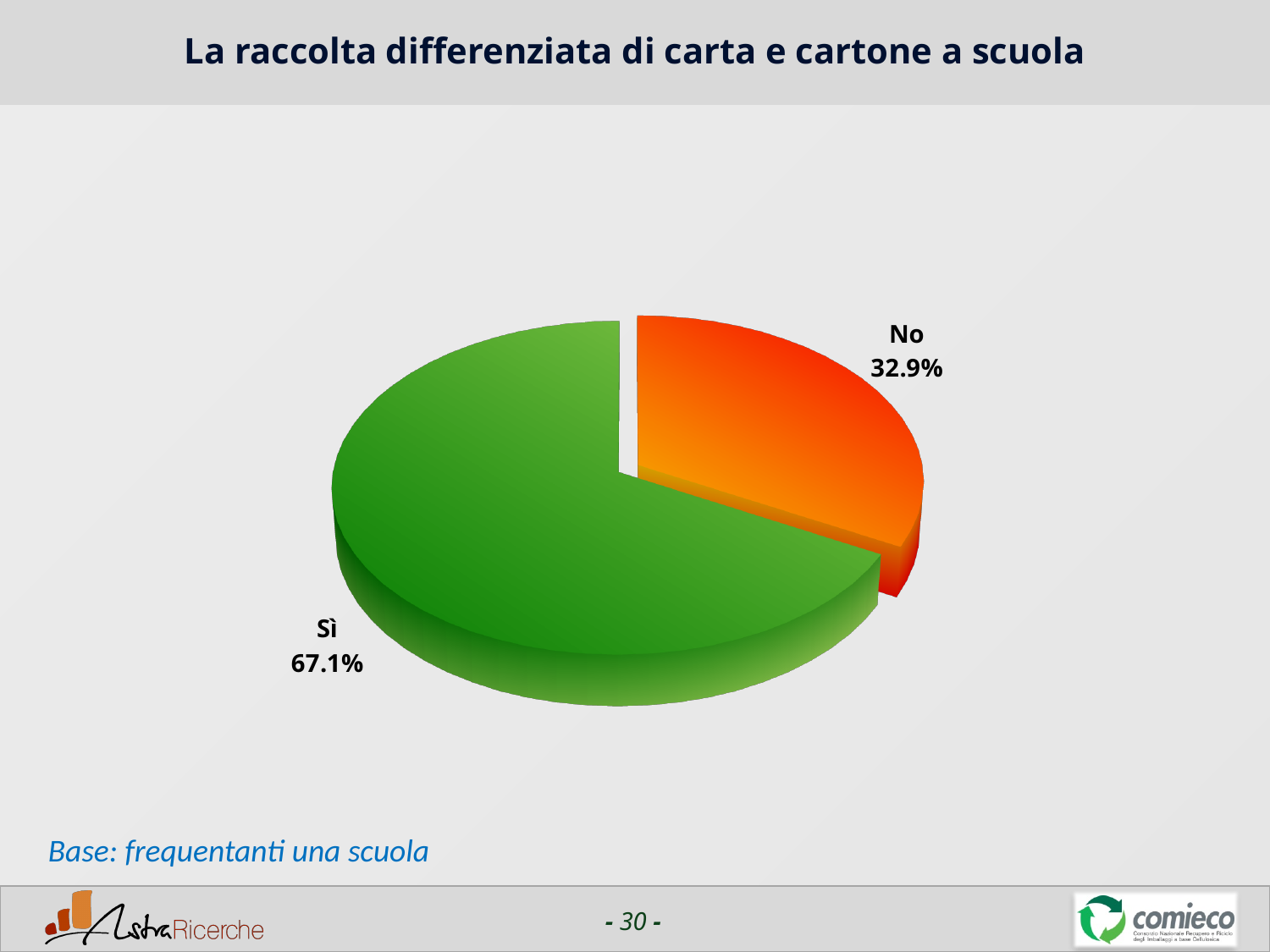
What kind of chart is shown on the slide? Pie chart Which is larger, the "Sì" slice or the "No" slice? Sì What is the difference in percentage points between the "Sì" and "No" slices? 34.2 How many slices does the pie chart have? 2 What percentage of respondents answered "Sì"? 67.1% What percentage of respondents answered "No"? 32.9% What share of the pie does the "No" slice represent? 32.9% Which slice of the pie is the largest? Sì What is the title of the slide? La raccolta differenziata di carta e cartone a scuola Which slice of the pie is the smallest? No What colour is the "Sì" slice? Green